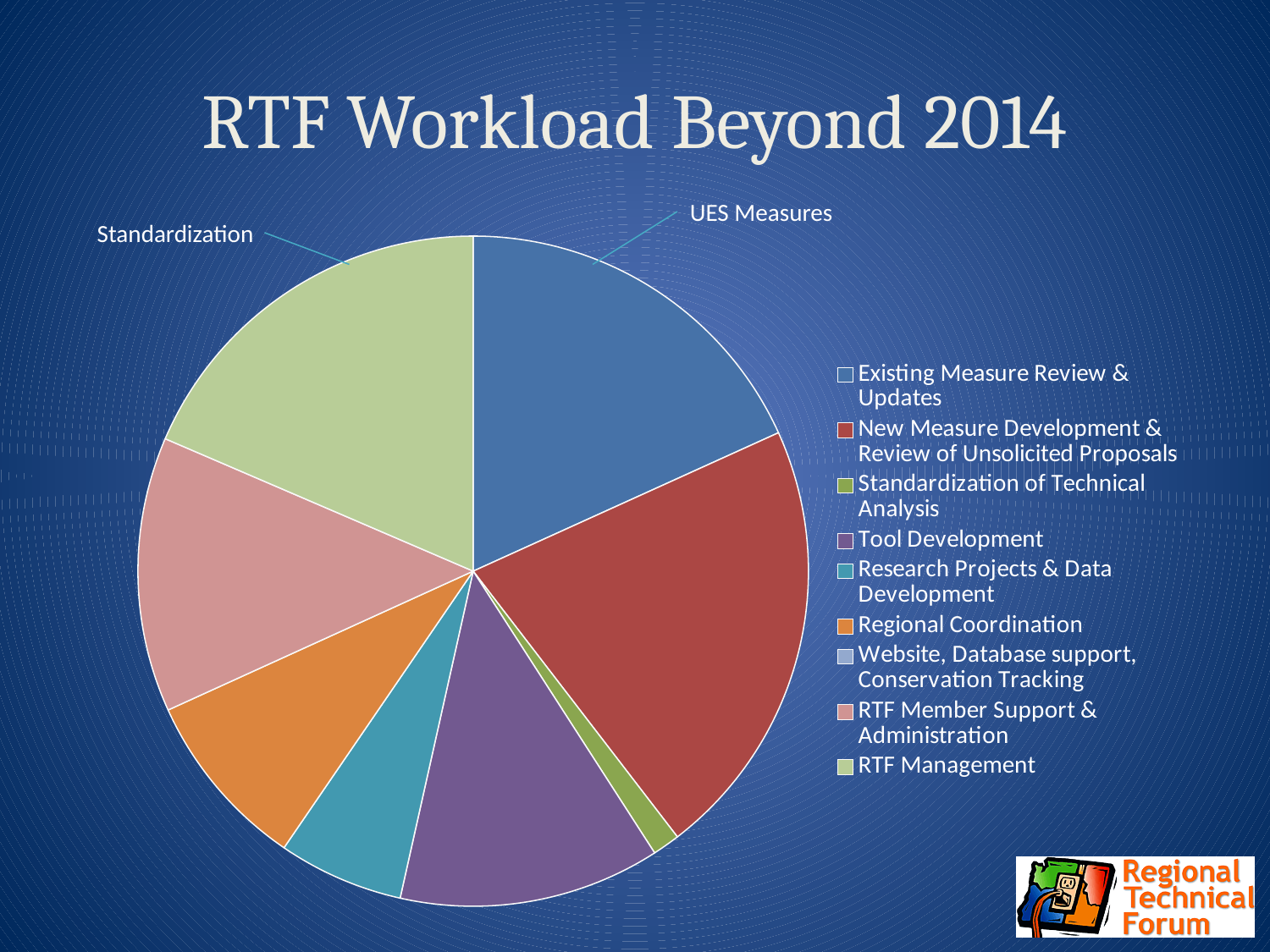
Which slice is larger: Standardization of Technical Analysis or Tool Development? Tool Development Which slice is larger: Existing Measure Review & Updates or Tool Development? Existing Measure Review & Updates Which slice is larger: Regional Coordination or Research Projects & Data Development? Regional Coordination What is the title of the chart on the slide? RTF Workload Beyond 2014 What callout label points to the blue slice at the top right of the pie? UES Measures How many categories does the legend of the pie chart list? 9 What kind of chart is shown on the slide? pie chart Which category has the largest slice of the pie? New Measure Development & Review of Unsolicited Proposals